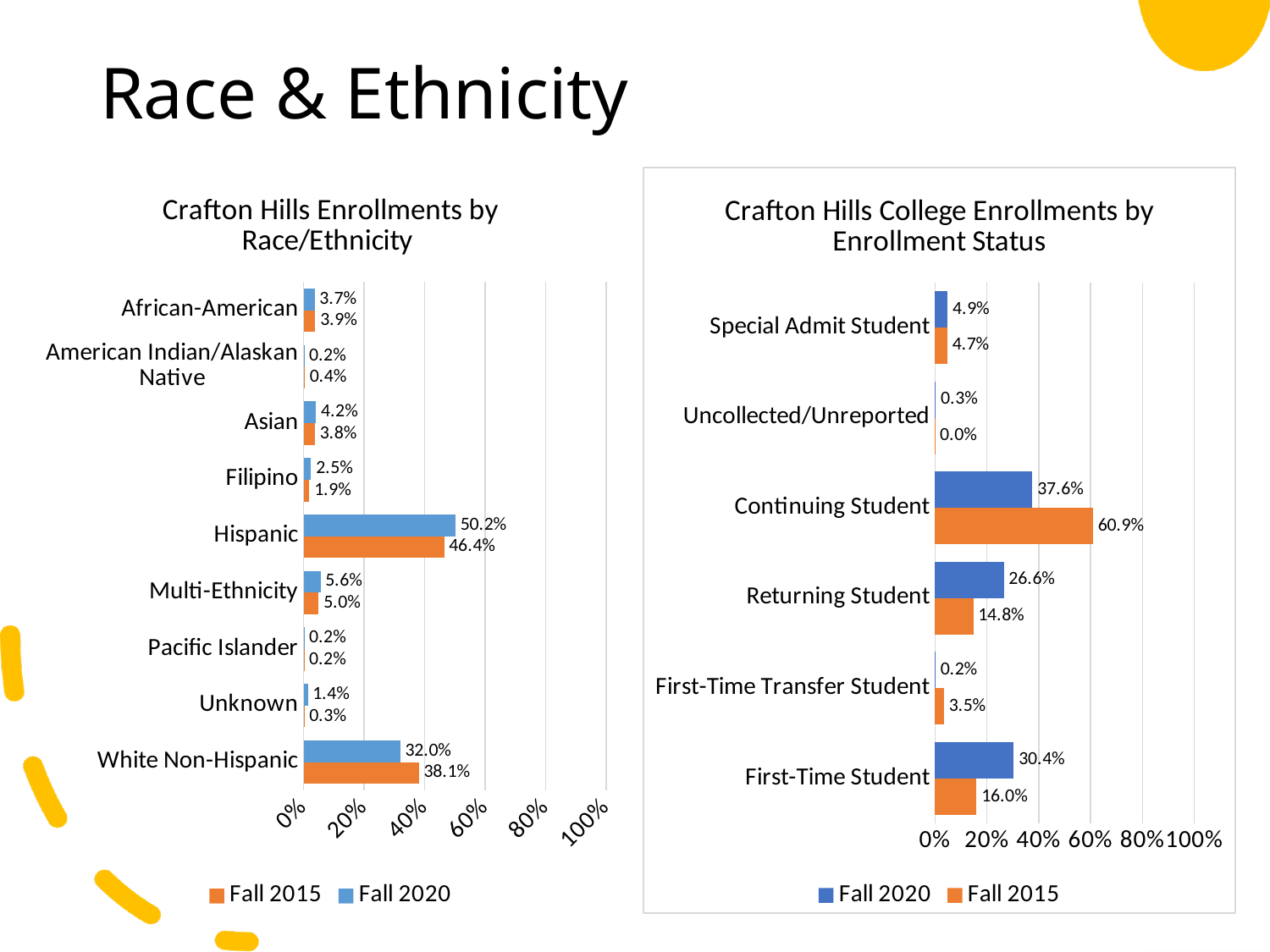
What type of chart is the 'Crafton Hills College Enrollments by Enrollment Status' chart? Bar chart In the 'Crafton Hills College Enrollments by Enrollment Status' chart, which is larger for Returning Student: the Fall 2020 value or the Fall 2015 value? Fall 2020 In the 'Crafton Hills College Enrollments by Enrollment Status' chart, what is the Fall 2020 value for First-Time Student? 30.4% In the 'Crafton Hills Enrollments by Race/Ethnicity' chart, what is the Fall 2015 value for White Non-Hispanic? 38.1% In the 'Crafton Hills Enrollments by Race/Ethnicity' chart, what is the difference between the Fall 2015 and Fall 2020 values for White Non-Hispanic? 6.1% In the 'Crafton Hills Enrollments by Race/Ethnicity' chart, is the Fall 2020 value for Hispanic greater or less than 40%? greater In the 'Crafton Hills College Enrollments by Enrollment Status' chart, what is the Fall 2015 value for Continuing Student? 60.9% In the 'Crafton Hills College Enrollments by Enrollment Status' chart, how many series does the legend list? 2 In the 'Crafton Hills Enrollments by Race/Ethnicity' chart, what is the Fall 2020 value for Hispanic? 50.2% In the 'Crafton Hills College Enrollments by Enrollment Status' chart, what is the difference between the Fall 2015 and Fall 2020 values for Continuing Student? 23.3% In the 'Crafton Hills Enrollments by Race/Ethnicity' chart, which category has the highest Fall 2020 value? Hispanic In the 'Crafton Hills Enrollments by Race/Ethnicity' chart, how many race/ethnicity categories are shown? 9